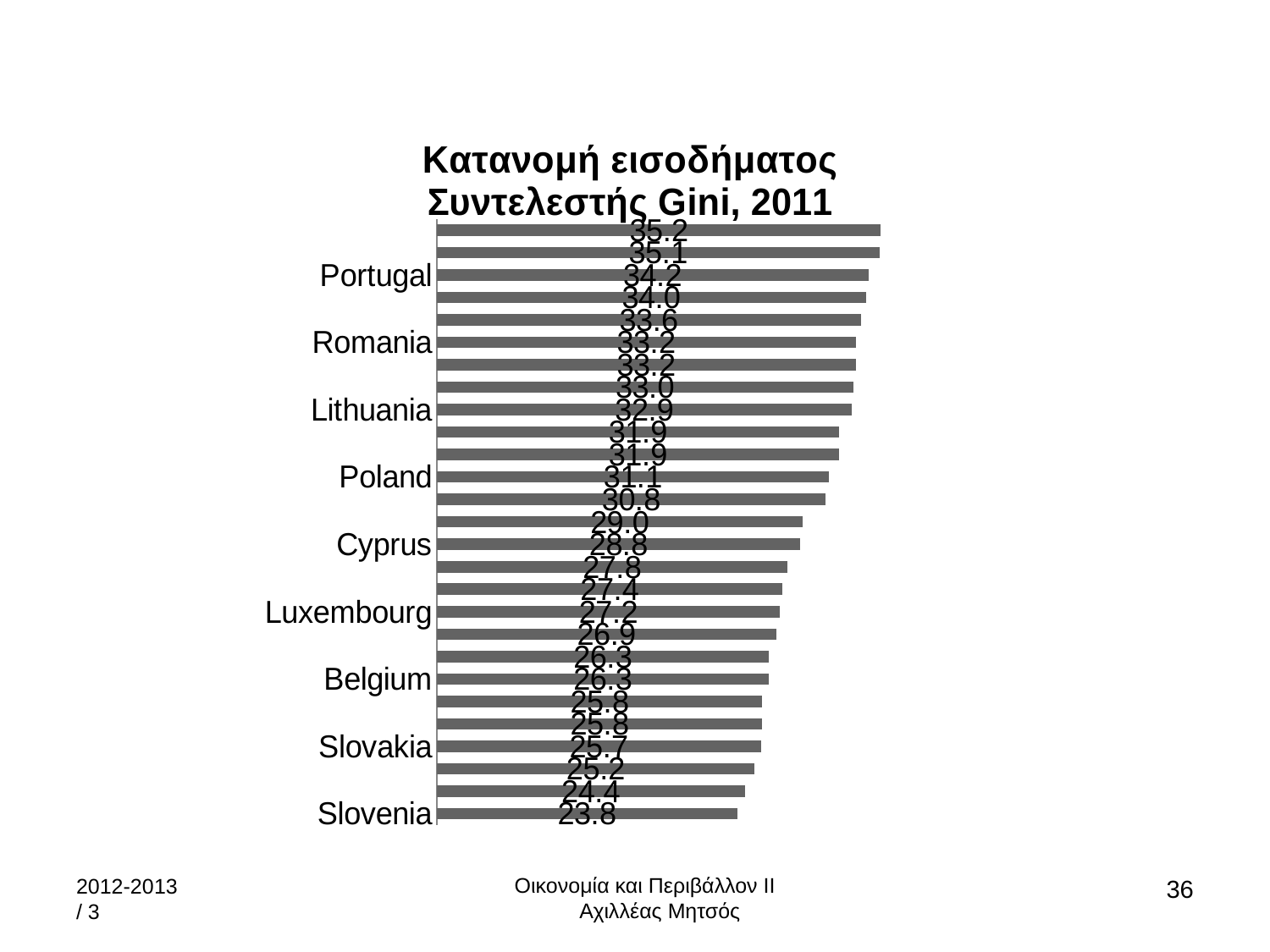
How many country labels are shown on the vertical axis? 9 Which has a higher Gini coefficient, Romania or Belgium? Romania What is the difference between the Gini coefficient of Portugal and that of Slovenia? 10.4 What is the Gini coefficient value shown for Portugal? 34.2 What kind of chart is shown on the slide? bar chart What is the Gini coefficient value shown for Cyprus? 28.8 What is the Gini coefficient value shown for Slovenia? 23.8 What is the Gini coefficient value shown for Poland? 31.1 Do the bar values rise or fall going from the top of the chart to the bottom? fall Which year does the chart title say the Gini coefficient data refers to? 2011 Which of the labelled countries has the highest Gini coefficient? Portugal Which of the labelled countries has the lowest Gini coefficient? Slovenia